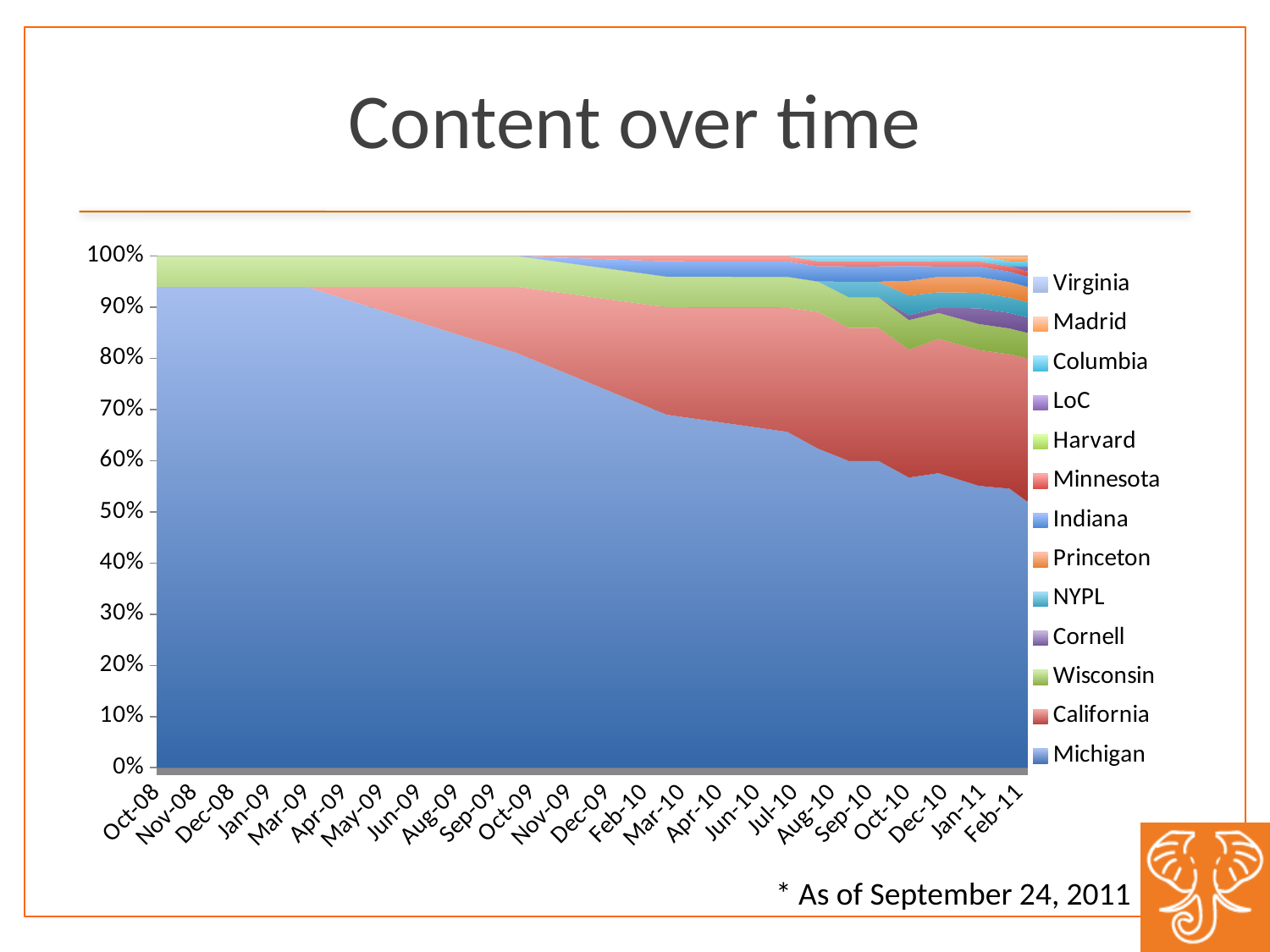
How many time points are labelled on the x axis? 24 Does Michigan's share of content rise or fall from Oct-08 to Feb-11? Fall Is Michigan's share in Jul-10 greater or less than 60%? greater In Feb-11, which has the larger share of content, Michigan or California? Michigan What is the first time point on the x axis? Oct-08 Which series accounts for the largest share of content across the whole period? Michigan Is Michigan's share in Feb-11 greater or less than 60%? less Is Michigan's share in Oct-08 greater or less than 90%? greater What is the title of the chart? Content over time How many series does the legend list? 13 Which series is listed first in the legend? Virginia What kind of chart is shown on the slide? Stacked area chart